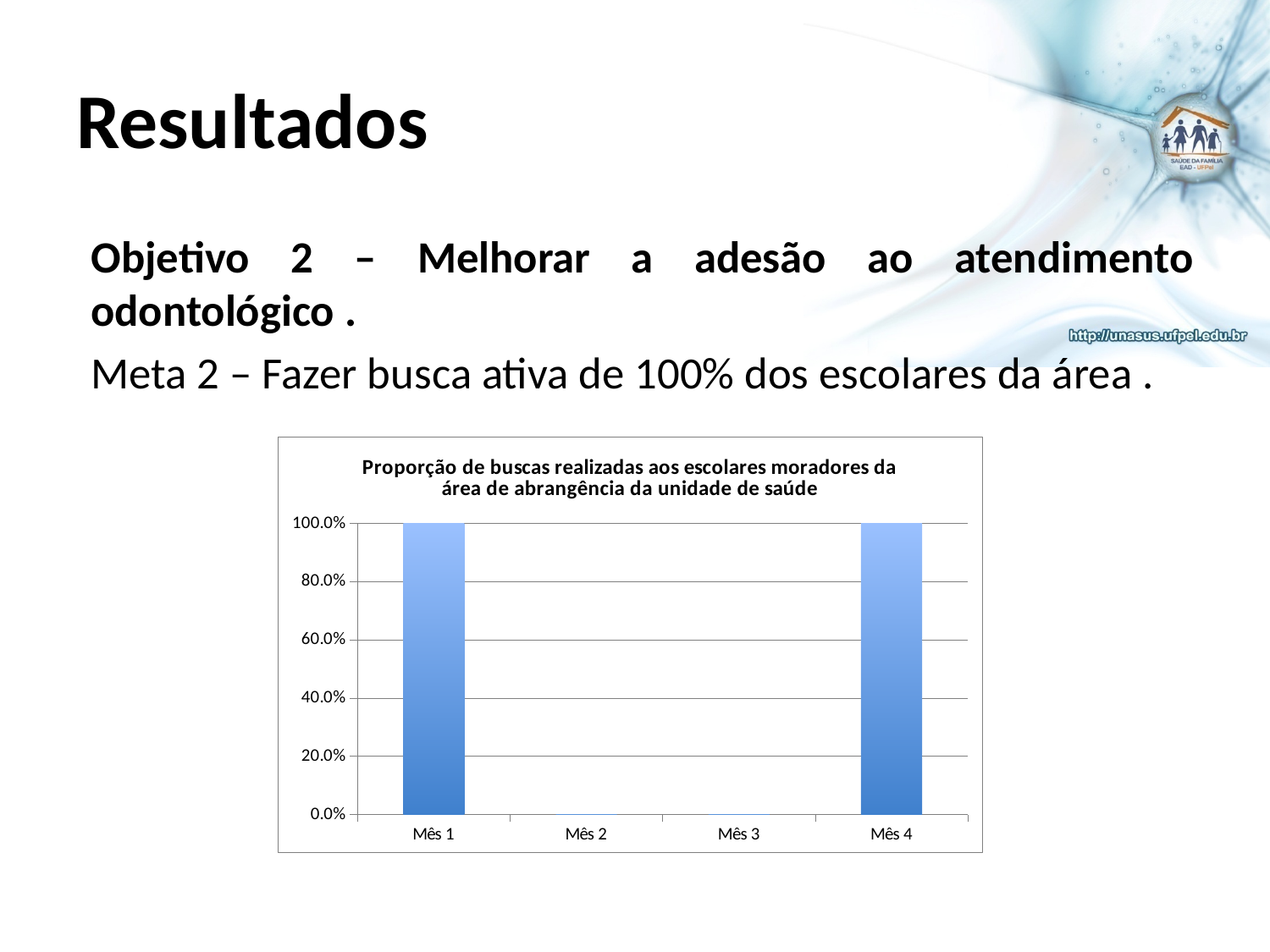
What is the value for Mês 1 in the chart? 100.0% What is the value for Mês 4 in the chart? 100.0% Is the value for Mês 2 greater or less than 20.0%? less Which is larger, the value for Mês 3 or the value for Mês 4? Mês 4 Which is larger, the value for Mês 1 or the value for Mês 2? Mês 1 What kind of chart is shown on the slide? bar chart Is the value for Mês 1 greater or less than 80.0%? greater What is the difference between the values for Mês 4 and Mês 3? 100.0% What is the value for Mês 2 in the chart? 0.0% What is the title of the chart? Proporção de buscas realizadas aos escolares moradores da área de abrangência da unidade de saúde How many categories are shown on the x axis of the chart? 4 What is the value for Mês 3 in the chart? 0.0%